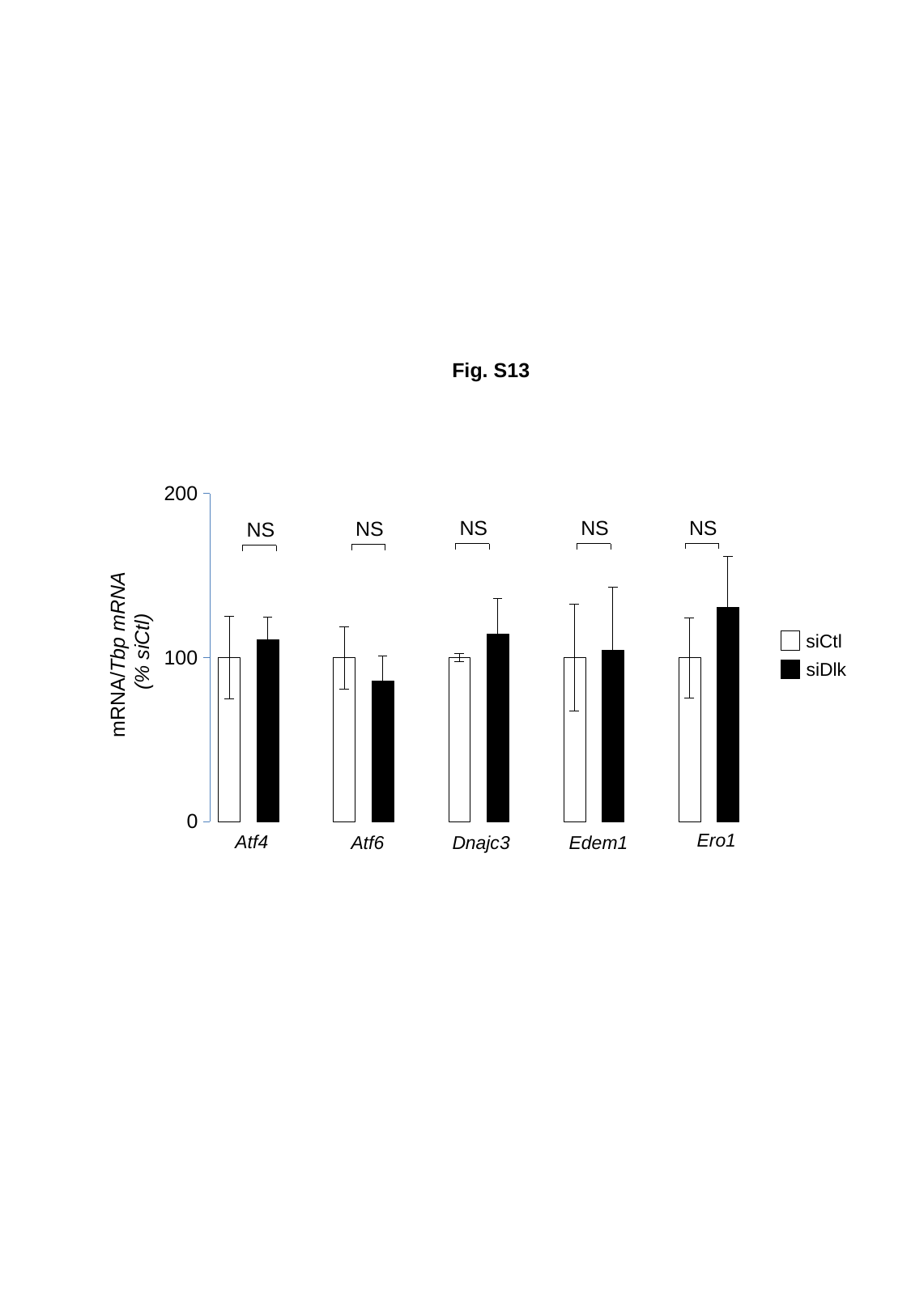
How many gene categories are shown on the x axis? 5 What label is shown above each pair of bars? NS Which gene has the lowest siDlk bar? Atf6 Is the siDlk value for Atf4 greater or less than 100? greater Is the siDlk value for Ero1 greater or less than 100? greater How many series does the legend list? 2 What is the value of the siCtl bar for Atf4? 100 Which gene has the highest siDlk bar? Ero1 What kind of chart is shown on the slide? bar chart For Atf6, which bar is larger, siCtl or siDlk? siCtl Is the siDlk value for Atf6 greater or less than 100? less What is the value of the siCtl bar for Dnajc3? 100